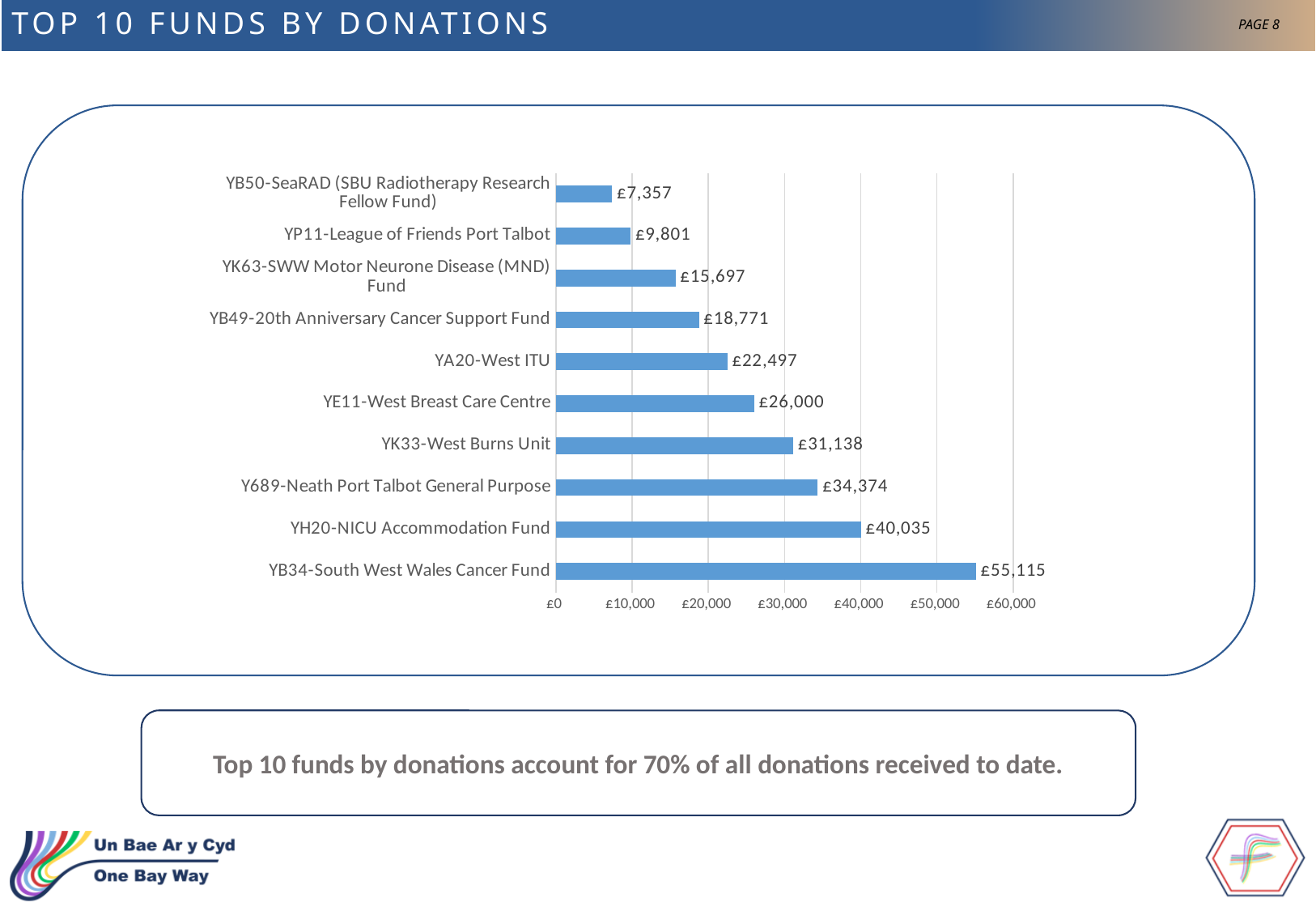
Which fund has the highest donation value? YB34-South West Wales Cancer Fund What is the donation value for YB34-South West Wales Cancer Fund? £55,115 Which fund has the lowest donation value? YB50-SeaRAD (SBU Radiotherapy Research Fellow Fund) What is the difference between the donations for YK33-West Burns Unit and YE11-West Breast Care Centre? £5,138 Is the value for YB49-20th Anniversary Cancer Support Fund greater or less than £20,000? less What is the difference between the donations for YB34-South West Wales Cancer Fund and YH20-NICU Accommodation Fund? £15,080 Which has a larger donation value, Y689-Neath Port Talbot General Purpose or YK33-West Burns Unit? Y689-Neath Port Talbot General Purpose What is the donation value for YA20-West ITU? £22,497 How many funds are shown in the chart? 10 What is the donation value for YH20-NICU Accommodation Fund? £40,035 What is the title of the slide containing the chart? TOP 10 FUNDS BY DONATIONS What kind of chart is shown on the slide? Bar chart